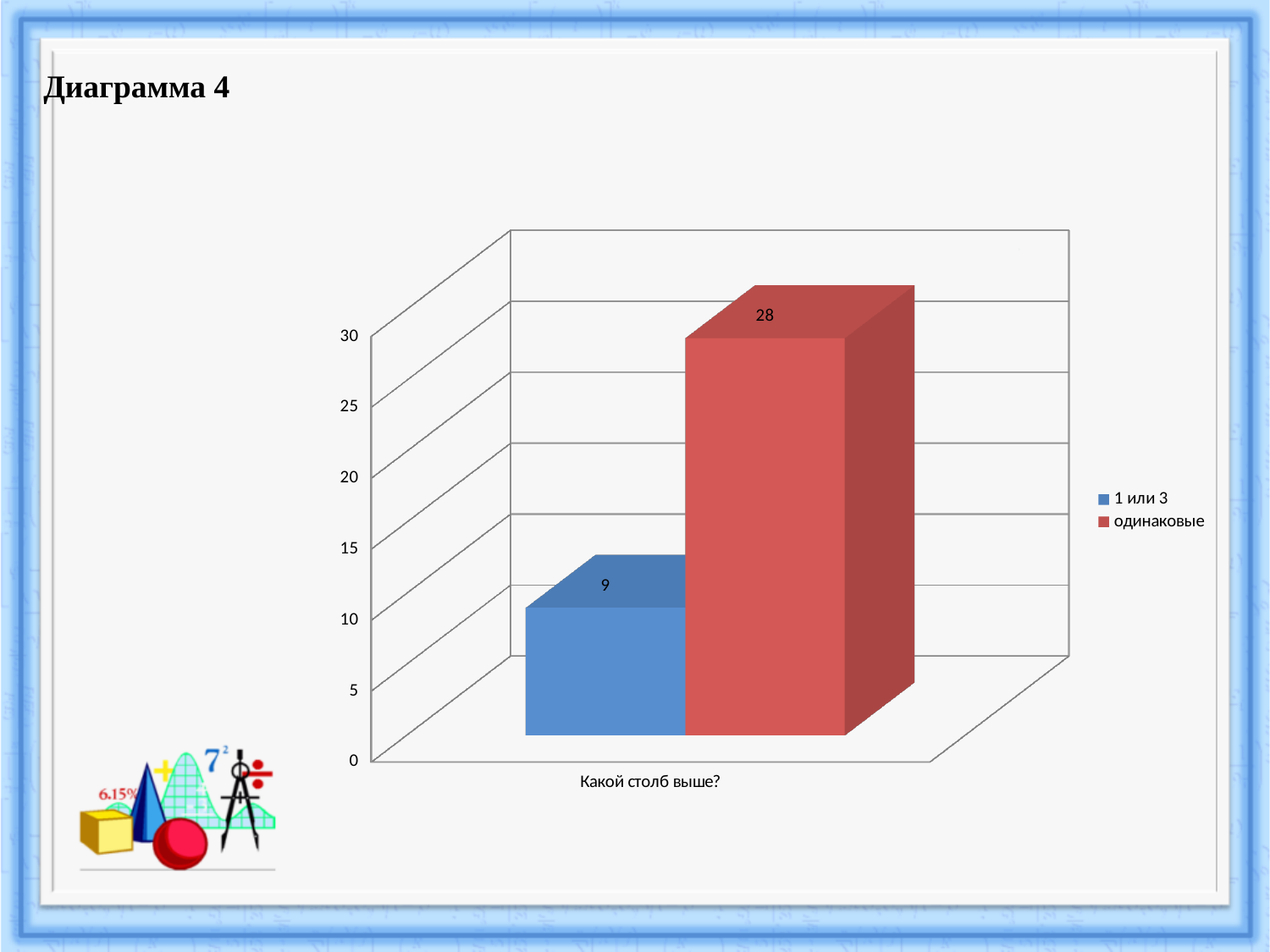
Is the value for "одинаковые" greater or less than 25? greater What is the difference between the values for "одинаковые" and "1 или 3"? 19 Which series has the higher value? одинаковые What colour is the bar for the series "одинаковые"? red How many series does the legend list? 2 What is the category label shown on the x axis? Какой столб выше? What kind of chart is shown on the slide? bar chart Is the value for "1 или 3" greater or less than 10? less Is the value for "1 или 3" larger or smaller than the value for "одинаковые"? smaller What is the value for the series "одинаковые"? 28 What is the value for the series "1 или 3"? 9 Which series has the lower value? 1 или 3